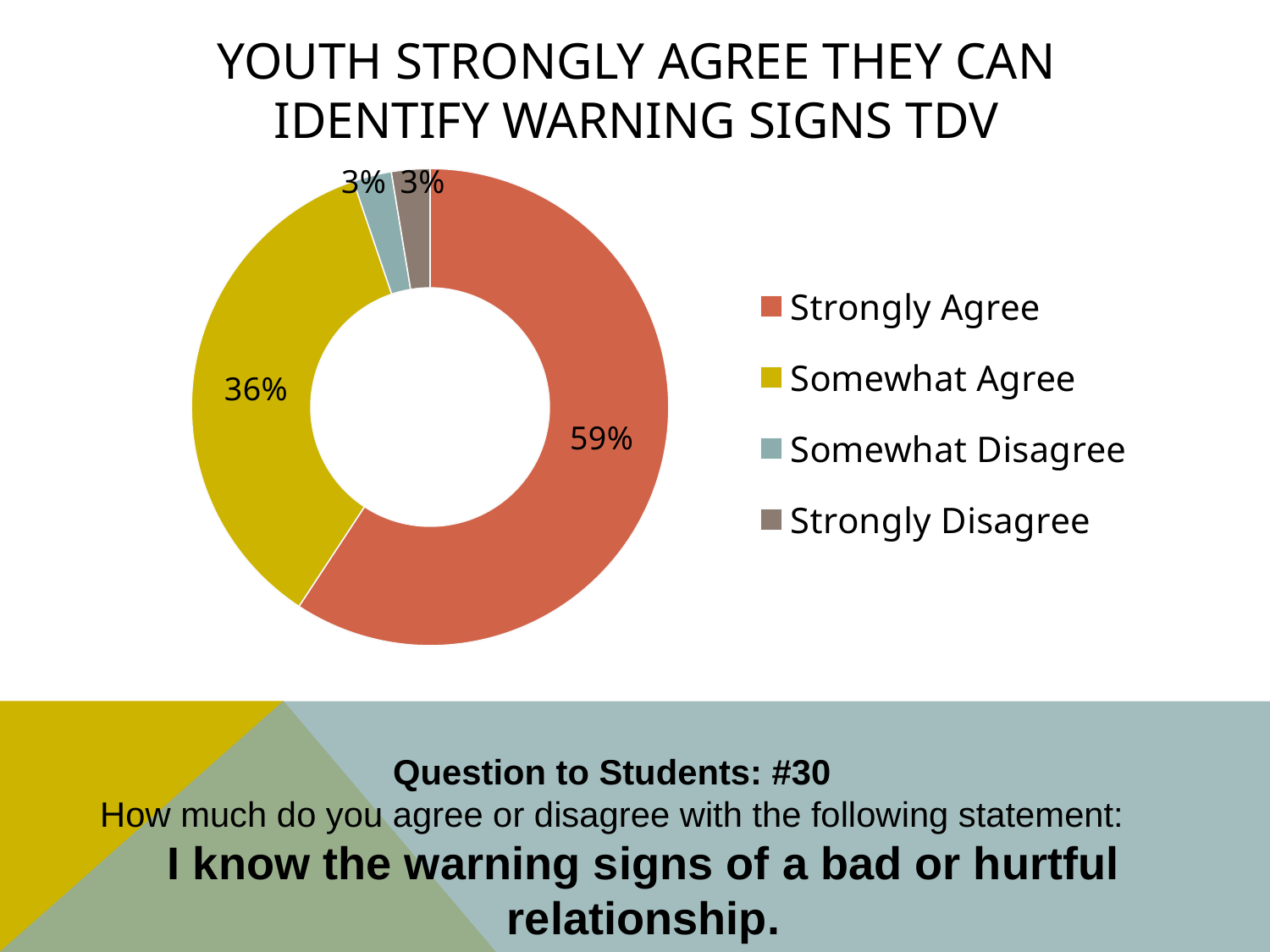
Which response category has the largest share of the chart? Strongly Agree What kind of chart is shown on the slide? Doughnut (pie) chart Which is larger, the share for Somewhat Agree or the share for Strongly Agree? Strongly Agree How many response categories are shown in the chart? 4 What percentage of youth responded Somewhat Agree? 36% What is the combined share of Strongly Agree and Somewhat Agree? 95% What percentage of youth responded Somewhat Disagree? 3% What percentage of youth responded Strongly Disagree? 3% What is the title of the chart? YOUTH STRONGLY AGREE THEY CAN IDENTIFY WARNING SIGNS TDV What percentage of youth responded Strongly Agree? 59% What is the difference in percentage points between Strongly Agree and Somewhat Agree? 23 Which colour represents Somewhat Agree in the legend? Yellow